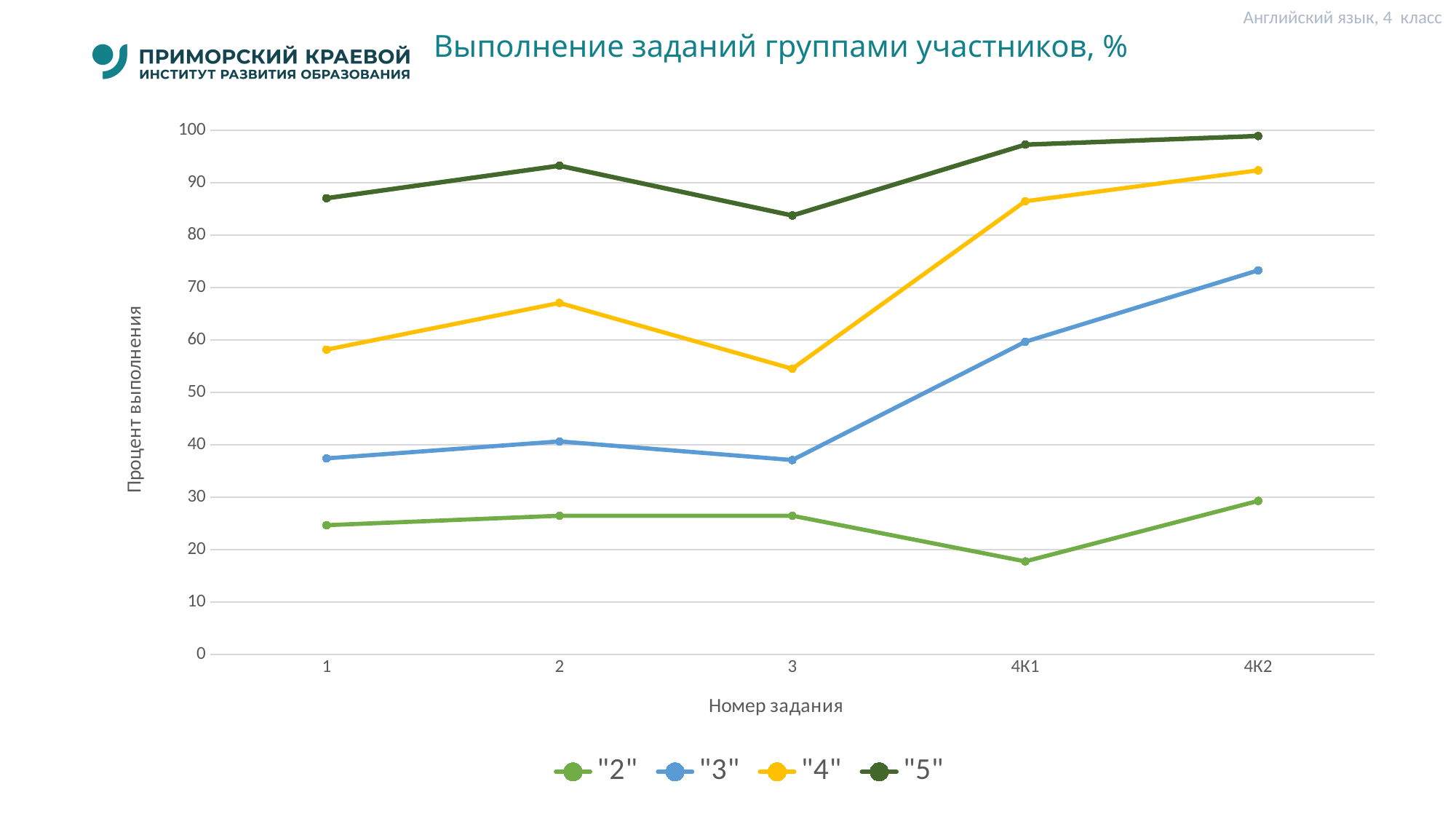
What kind of chart is shown on the slide? line chart Is the value for the "2" series at task 4К1 greater or less than 20? less For the "5" series, which task has the lowest completion percentage? 3 Is the value for the "4" series at task 4К1 greater or less than 80? greater Does the "3" series rise or fall from task 3 to task 4К2? rises Is the value for the "3" series at task 4К2 greater or less than 70? greater How many task numbers are plotted along the x axis? 5 For the "2" series, which task has the lowest completion percentage? 4К1 For the "5" series, which is larger: the value at task 2 or at task 3? task 2 How many series does the legend list? 4 What is the title of the chart? Выполнение заданий группами участников, % For the "4" series, which task has the lowest completion percentage? 3